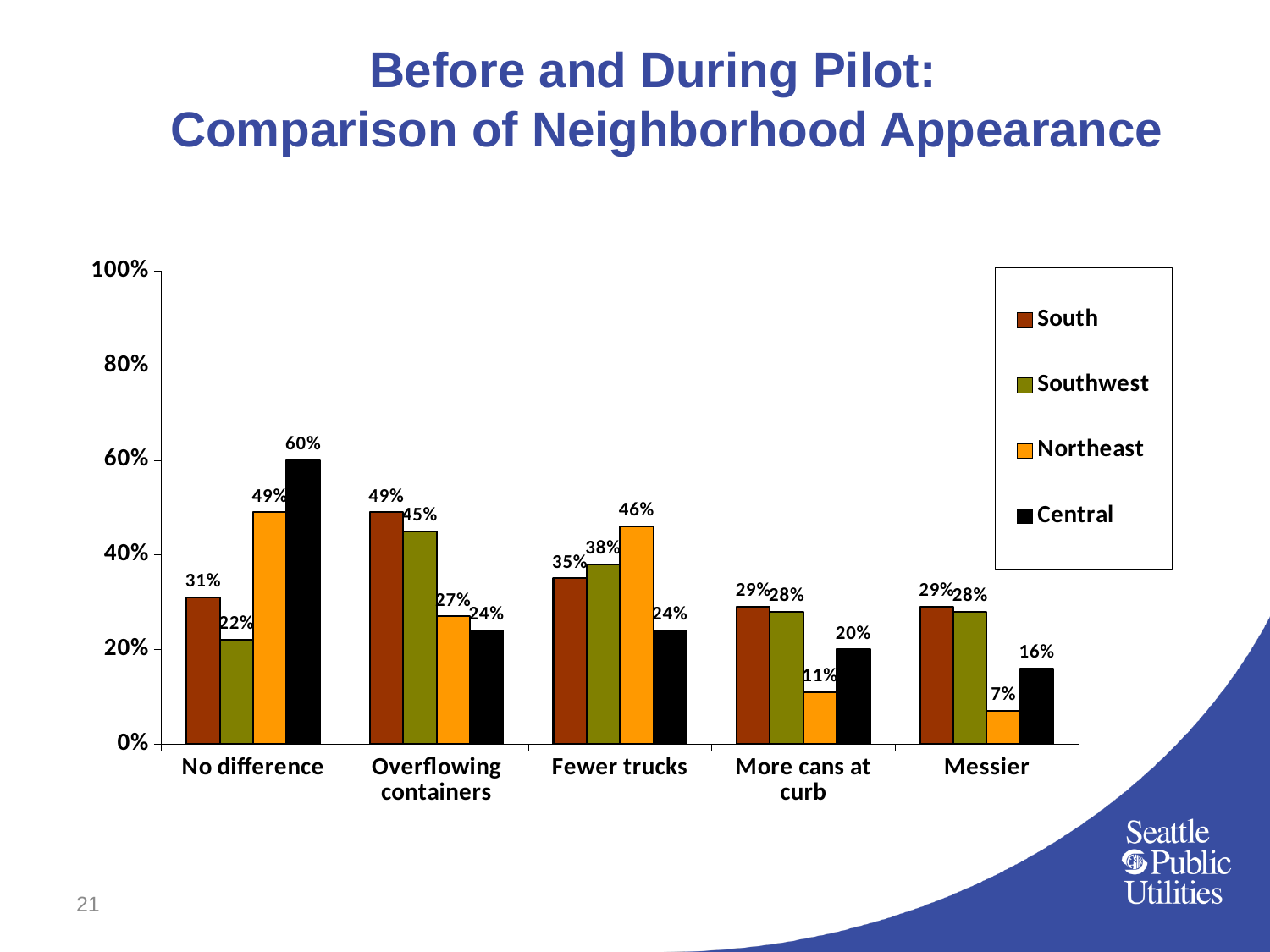
What is the difference between the Central and South values in the No difference category? 29% Which is larger in the Fewer trucks category: the Southwest value or the Central value? Southwest What kind of chart is shown on the slide? Bar chart What is the value for Northeast in the Messier category? 7% How many categories are shown on the x axis? 5 Which region has the highest value in the Overflowing containers category? South What is the title of the chart on the slide? Before and During Pilot: Comparison of Neighborhood Appearance What is the value for Northeast in the Fewer trucks category? 46% What is the value for Central in the No difference category? 60% Which colour represents the Northeast series in the legend? Orange How many series does the legend list? 4 Which region has the lowest value in the More cans at curb category? Northeast